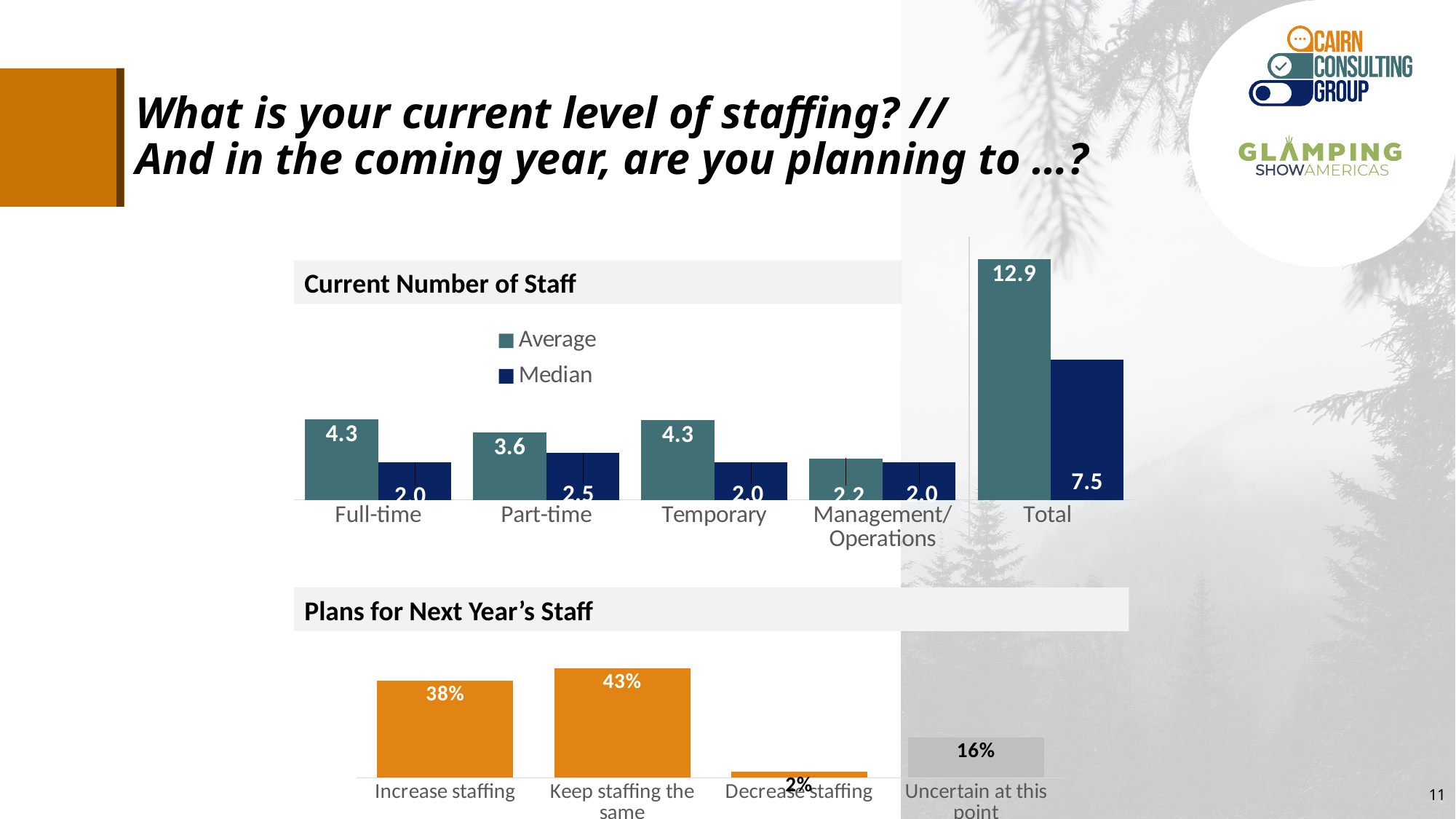
In the 'Current Number of Staff' chart, which is larger: the Median for Part-time or the Median for Full-time? Part-time How many categories are shown in the 'Current Number of Staff' chart? 5 In the 'Current Number of Staff' chart, what is the Median value for Total staff? 7.5 In the 'Current Number of Staff' chart, what is the Average value for Management/Operations? 2.2 In the 'Plans for Next Year's Staff' chart, what is the difference between 'Increase staffing' and 'Uncertain at this point'? 22% How many series does the legend of the 'Current Number of Staff' chart list? 2 In the 'Current Number of Staff' chart, what is the difference between the Average and Median values for Total? 5.4 What type of chart is the 'Plans for Next Year's Staff' chart? Bar chart In the 'Plans for Next Year's Staff' chart, what percentage plan to keep staffing the same? 43% In the 'Plans for Next Year's Staff' chart, which category has the lowest value? Decrease staffing In the 'Current Number of Staff' chart, which category has the highest Average value? Total In the 'Current Number of Staff' chart, what is the Average value for Part-time staff? 3.6